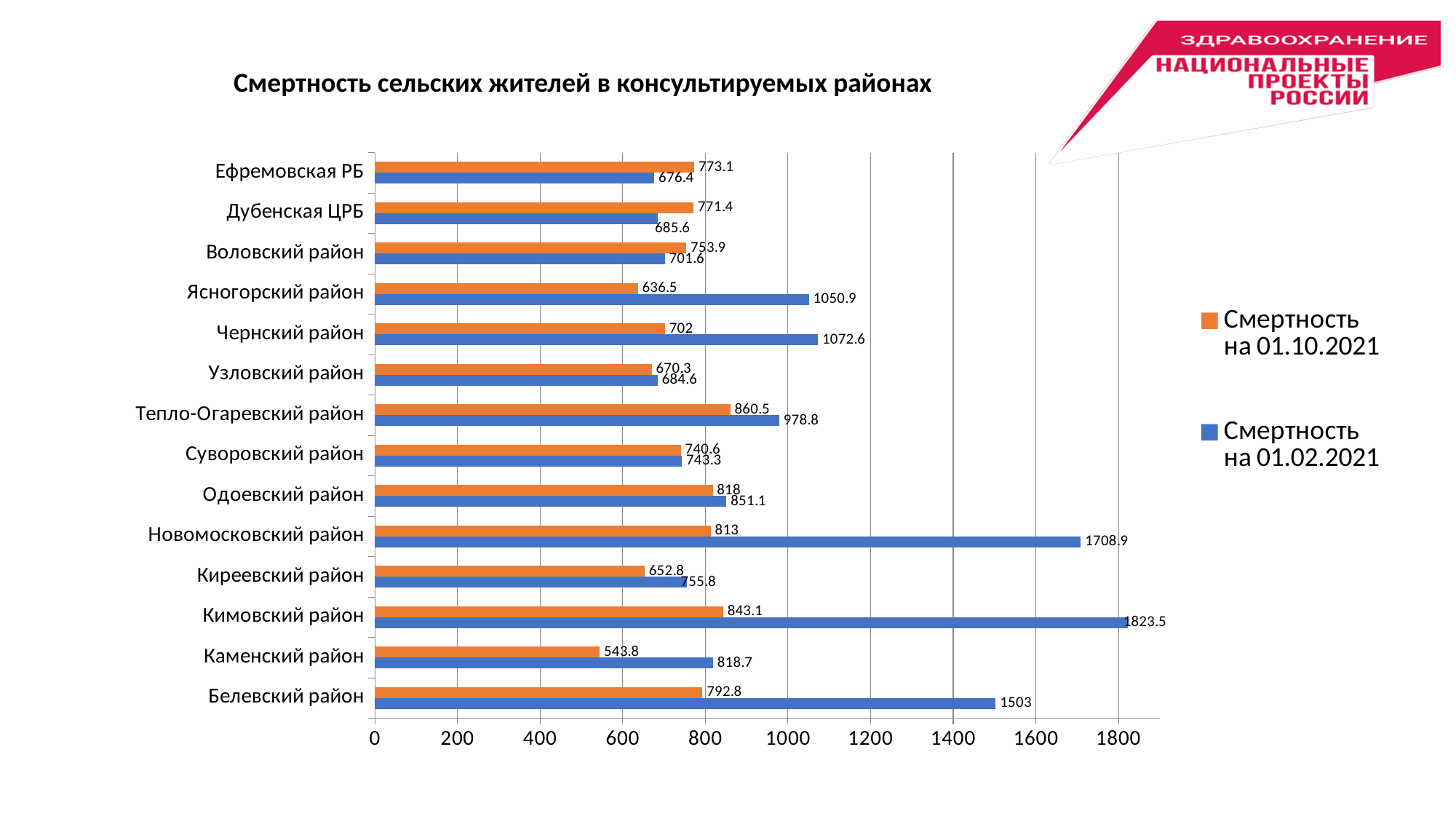
Which district has the lowest value for 'Смертность на 01.10.2021'? Каменский район What is the value of 'Смертность на 01.02.2021' for Кимовский район? 1823.5 Which district has the highest value for 'Смертность на 01.02.2021'? Кимовский район What type of chart is shown on the slide? bar chart For Ясногорский район, which is larger: 'Смертность на 01.10.2021' or 'Смертность на 01.02.2021'? Смертность на 01.02.2021 What is the value of 'Смертность на 01.10.2021' for Каменский район? 543.8 What is the value of 'Смертность на 01.02.2021' for Новомосковский район? 1708.9 What is the title of the chart? Смертность сельских жителей в консультируемых районах Is the value of 'Смертность на 01.02.2021' for Белевский район greater or less than 1400? greater What is the difference between 'Смертность на 01.02.2021' and 'Смертность на 01.10.2021' for Новомосковский район? 895.9 How many series does the legend list? 2 How many districts (categories) are shown in the chart? 14